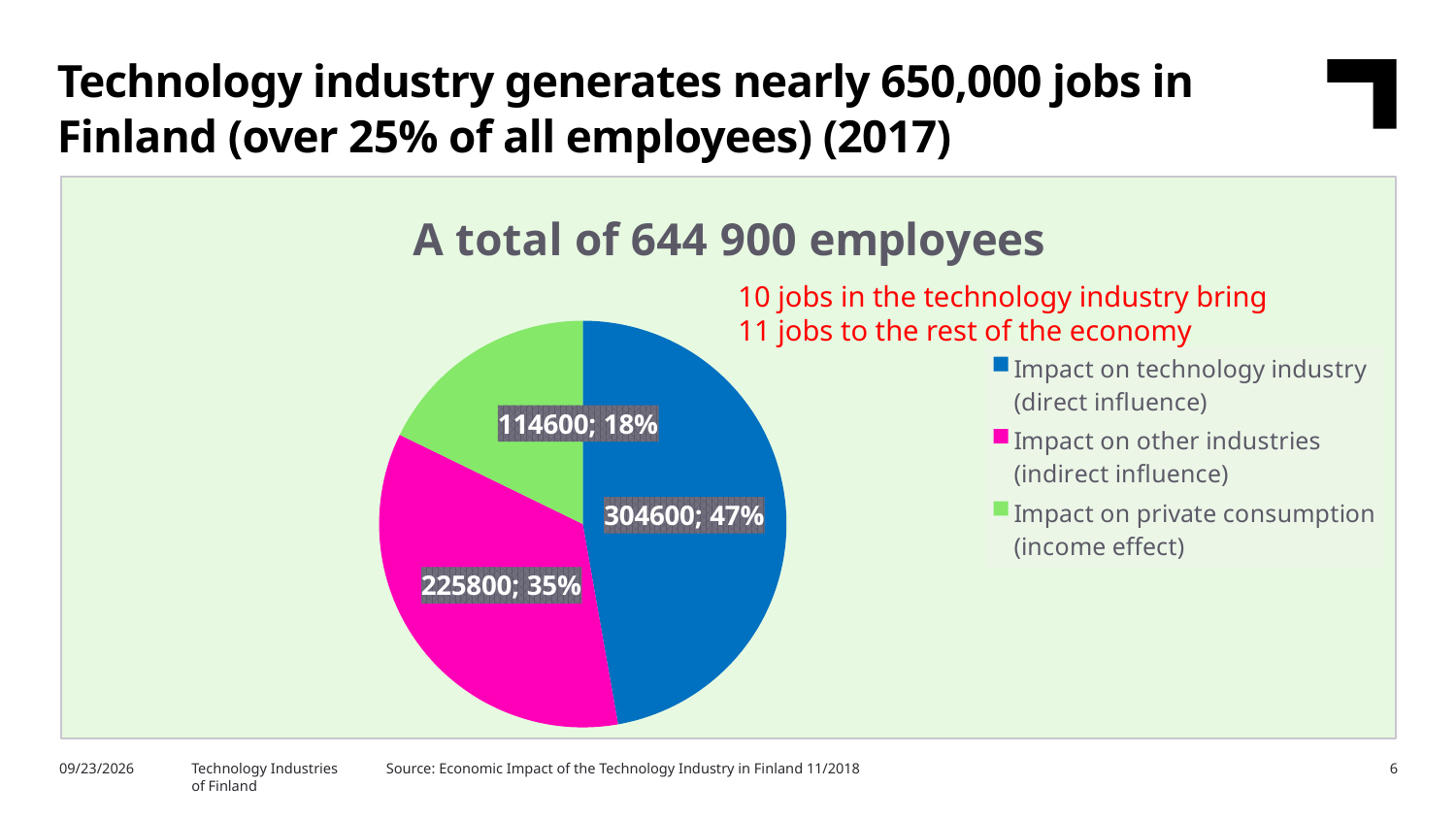
How many slices does the pie chart have? 3 What share of the pie does Impact on private consumption (income effect) represent? 18% What is the title of the chart? A total of 644 900 employees What is the value for Impact on technology industry (direct influence)? 304600 What is the difference between the values for Impact on technology industry (direct influence) and Impact on other industries (indirect influence)? 78800 What kind of chart is shown on the slide? Pie chart Which is larger: Impact on other industries (indirect influence) or Impact on private consumption (income effect)? Impact on other industries (indirect influence) What is the value for Impact on other industries (indirect influence)? 225800 What is the value for Impact on private consumption (income effect)? 114600 Which category has the smallest slice of the pie? Impact on private consumption (income effect) Which category has the largest slice of the pie? Impact on technology industry (direct influence) What share of the pie does Impact on other industries (indirect influence) represent? 35%